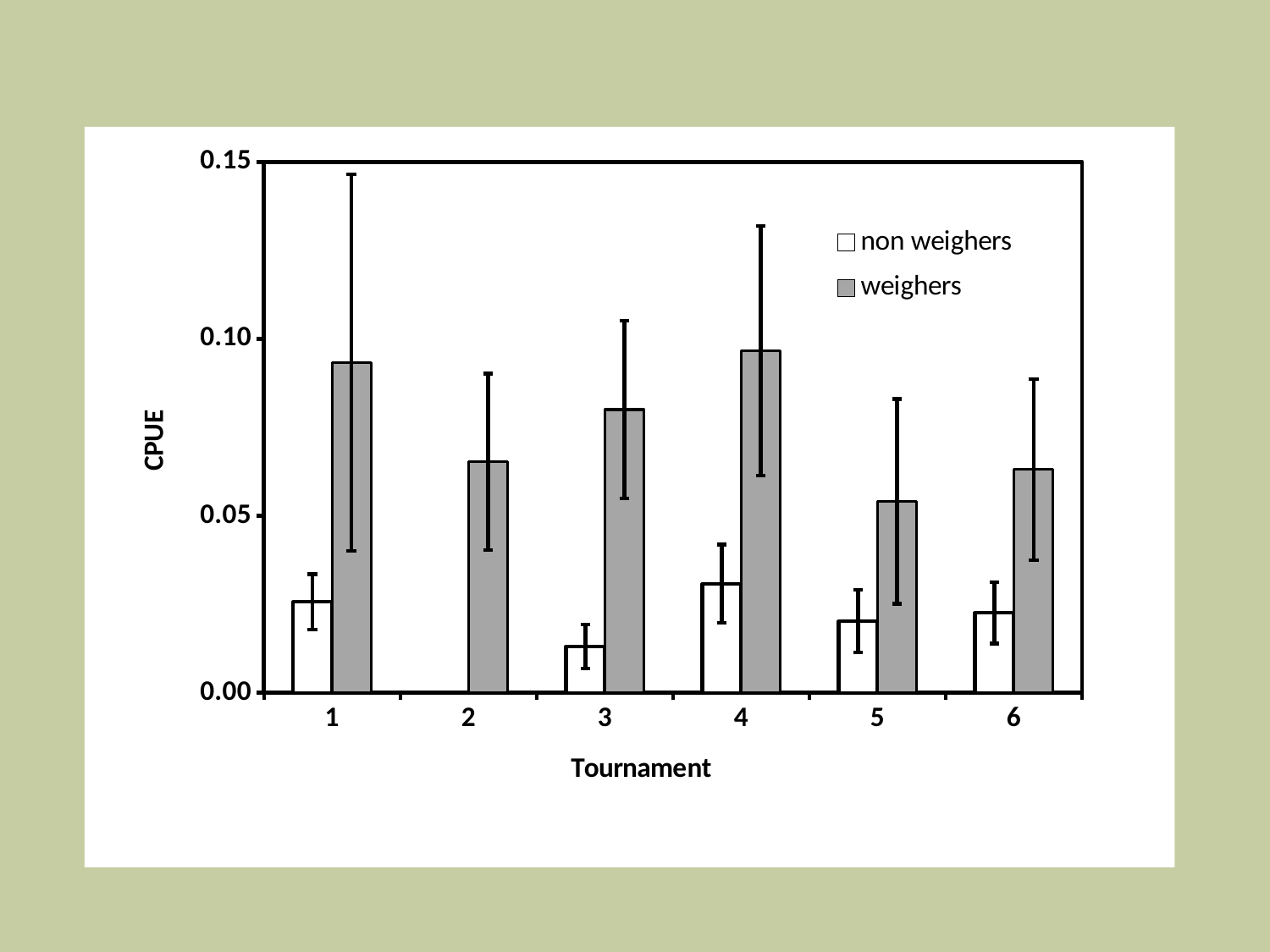
Is the value for weighers at tournament 2 greater or less than 0.05? greater Is the value for weighers at tournament 5 greater or less than 0.10? less For the weighers series, which tournament has the lowest value? 5 Is the value for non weighers at tournament 4 greater or less than 0.05? less How many tournaments are shown on the x axis? 6 At tournament 3, which series has the larger value, non weighers or weighers? weighers How many series does the legend list? 2 What are the two series named in the legend? non weighers and weighers What is the label of the y axis? CPUE What kind of chart is shown on the slide? bar chart